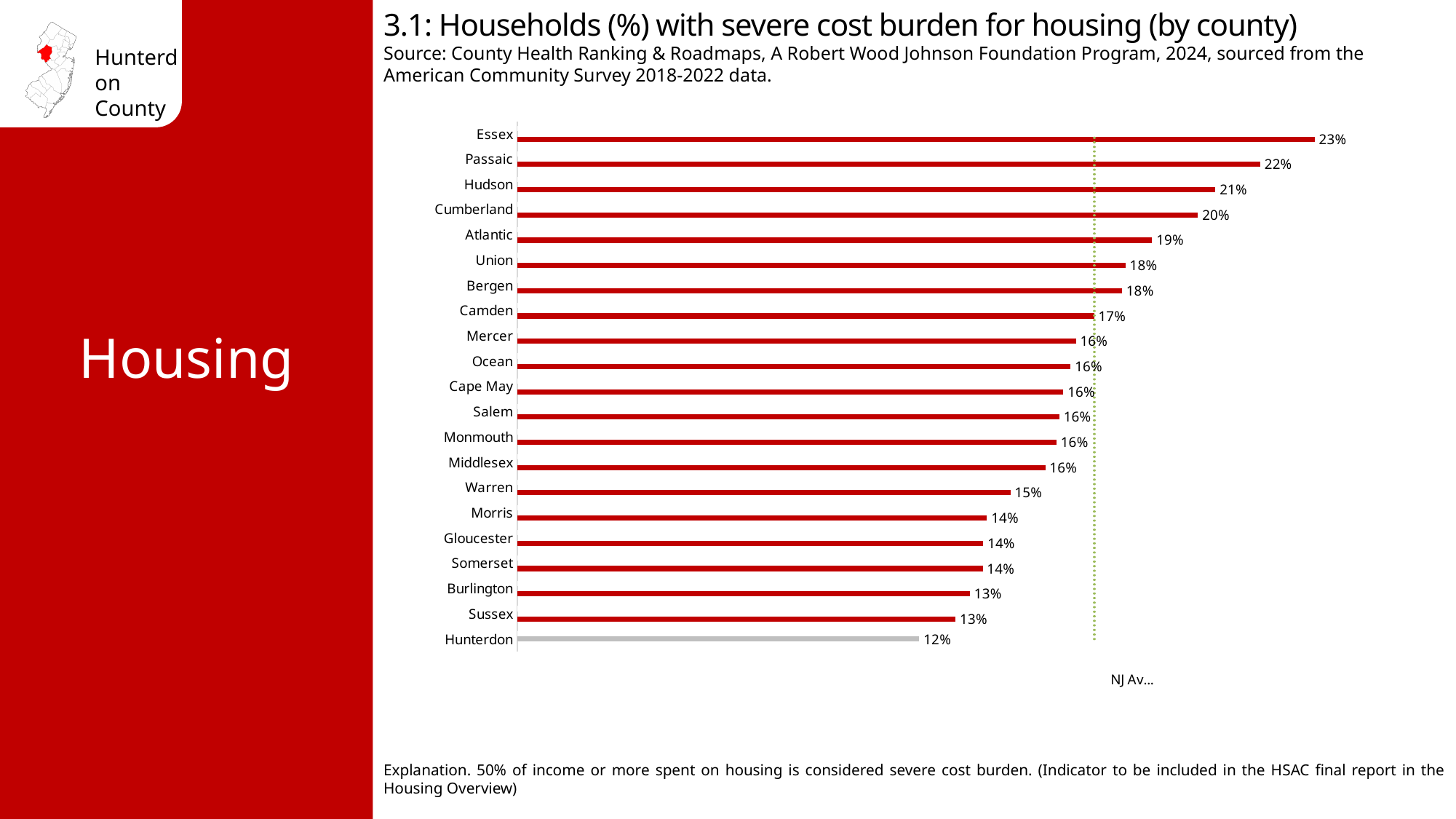
What is the value for Hunterdon? 12% What is the value for Cumberland? 20% Which county has the highest value? Essex How many counties are shown in the chart? 21 Which county has the lowest value? Hunterdon Which is larger, the value for Passaic or the value for Hudson? Passaic What is the value for Warren? 15% Which is larger, the value for Morris or the value for Warren? Warren Which county's bar is coloured grey instead of red? Hunterdon What is the difference between the values for Essex and Hunterdon? 11 percentage points What kind of chart is shown on the slide? Bar chart What is the difference between the values for Atlantic and Sussex? 6 percentage points